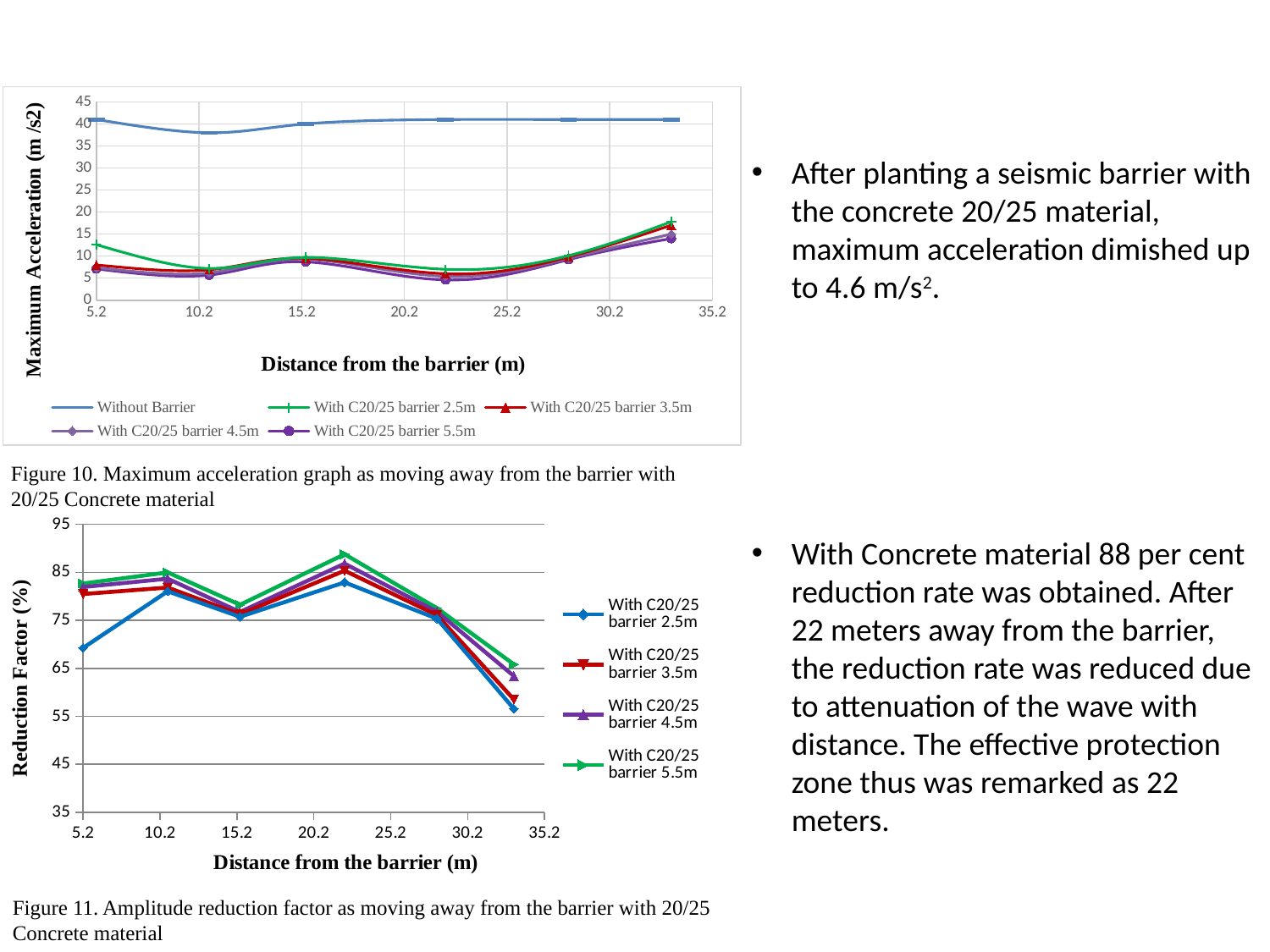
In the top chart (Figure 10), at 5.2 m, which is larger: the Without Barrier value or the With C20/25 barrier 2.5m value? Without Barrier What kind of chart is Figure 10 (the top chart)? Line chart In the bottom chart (Figure 11), is the value for the With C20/25 barrier 2.5m series at 5.2 m greater or less than 75? less In the bottom chart (Figure 11), do the reduction factor values rise or fall between about 22 m and the last point near 33 m? fall How many series does the legend of the top chart (Figure 10) list? 5 How many series does the legend of the bottom chart (Figure 11) list? 4 In the top chart (Figure 10), is the value for the Without Barrier series at 5.2 m greater or less than 35? greater In the top chart (Figure 10), do the barrier series rise or fall between about 22 m and the last point near 33 m? rise In the top chart (Figure 10), is the value for the With C20/25 barrier 2.5m series at 5.2 m greater or less than 15? less What is the y-axis label of the bottom chart (Figure 11)? Reduction Factor (%) In the bottom chart (Figure 11), which series has the lowest reduction factor at 5.2 m? With C20/25 barrier 2.5m